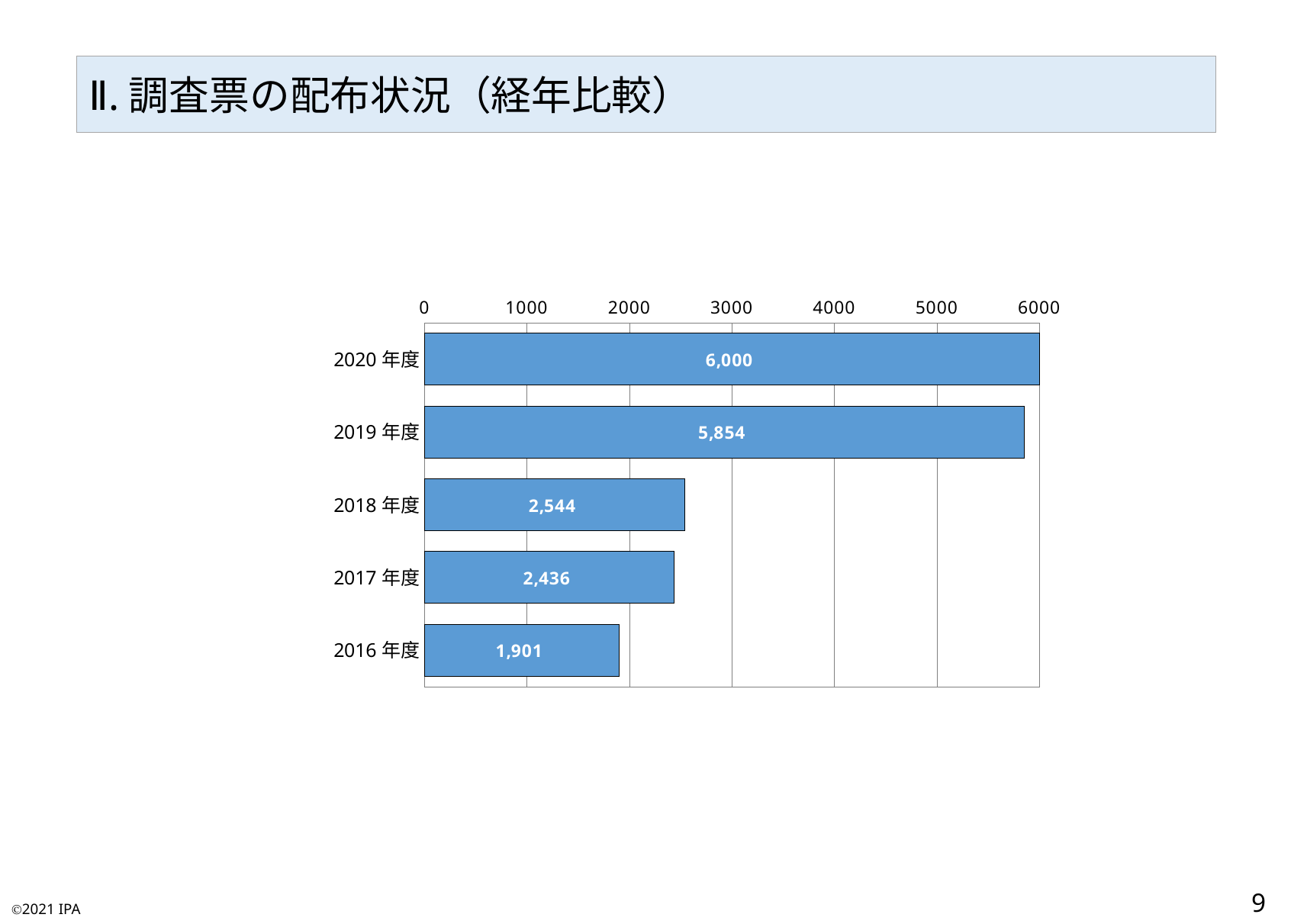
What is the value for 2020 年度? 6,000 What is the value for 2018 年度? 2,544 Which year has the lowest value? 2016 年度 What is the difference between the values for 2020 年度 and 2019 年度? 146 What is the value for 2016 年度? 1,901 How many years are shown in the chart? 5 What kind of chart is shown on the slide? Bar chart What is the difference between the values for 2018 年度 and 2017 年度? 108 What is the title of the slide? Ⅱ. 調査票の配布状況（経年比較） Which year has the highest value? 2020 年度 What is the value for 2019 年度? 5,854 Which is larger, the value for 2017 年度 or the value for 2016 年度? 2017 年度